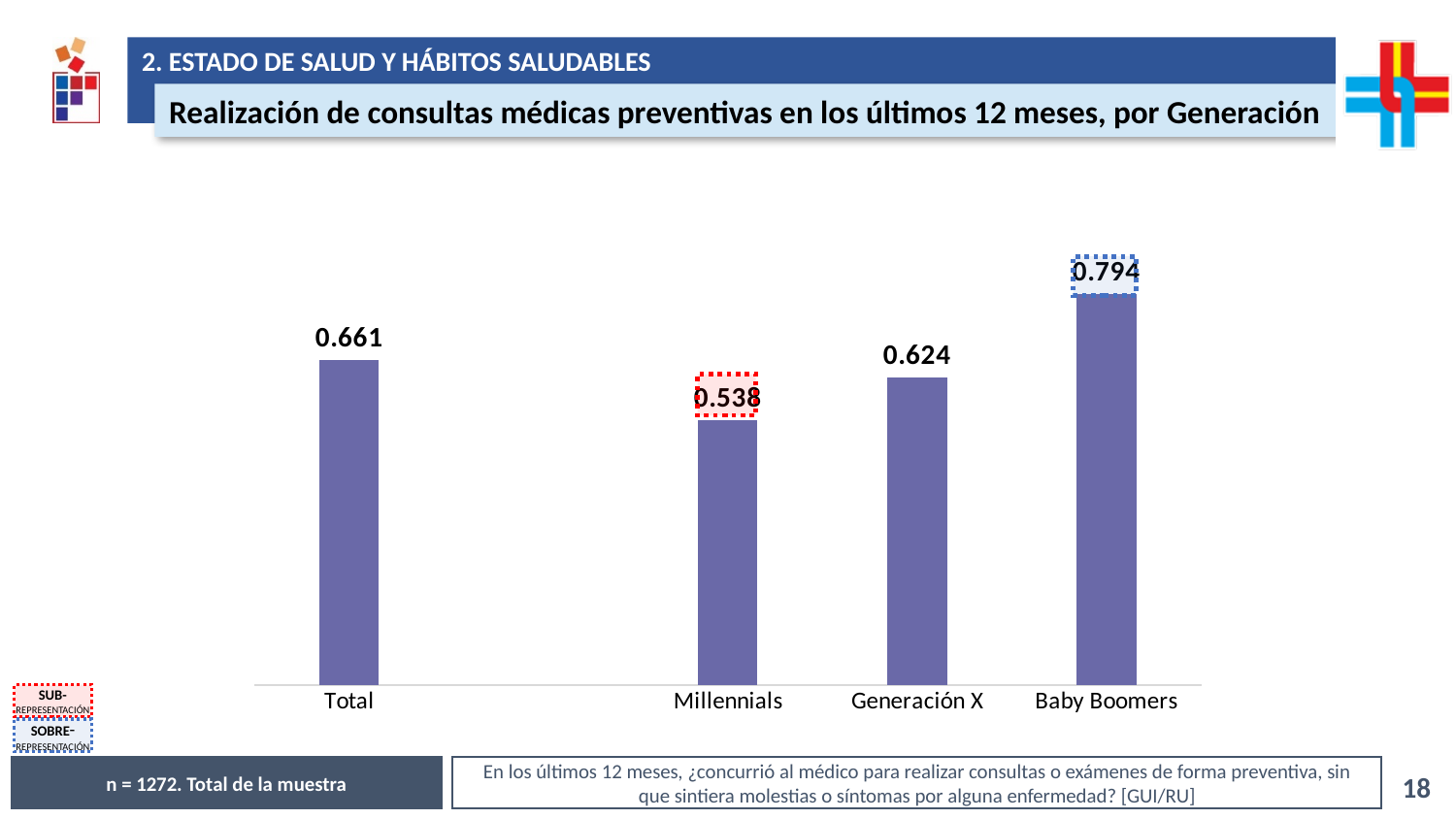
Which category has the highest value? Baby Boomers Which is larger, the value for Generación X or the value for Millennials? Generación X What is the title of the chart? Realización de consultas médicas preventivas en los últimos 12 meses, por Generación What is the difference between the values for Baby Boomers and Millennials? 0.256 What is the value for Generación X? 0.624 Which category has the lowest value? Millennials How many categories are shown on the chart? 4 What is the value for Baby Boomers? 0.794 What is the value for Total? 0.661 What is the difference between the values for Total and Generación X? 0.037 What kind of chart is shown on the slide? Bar chart What is the value for Millennials? 0.538